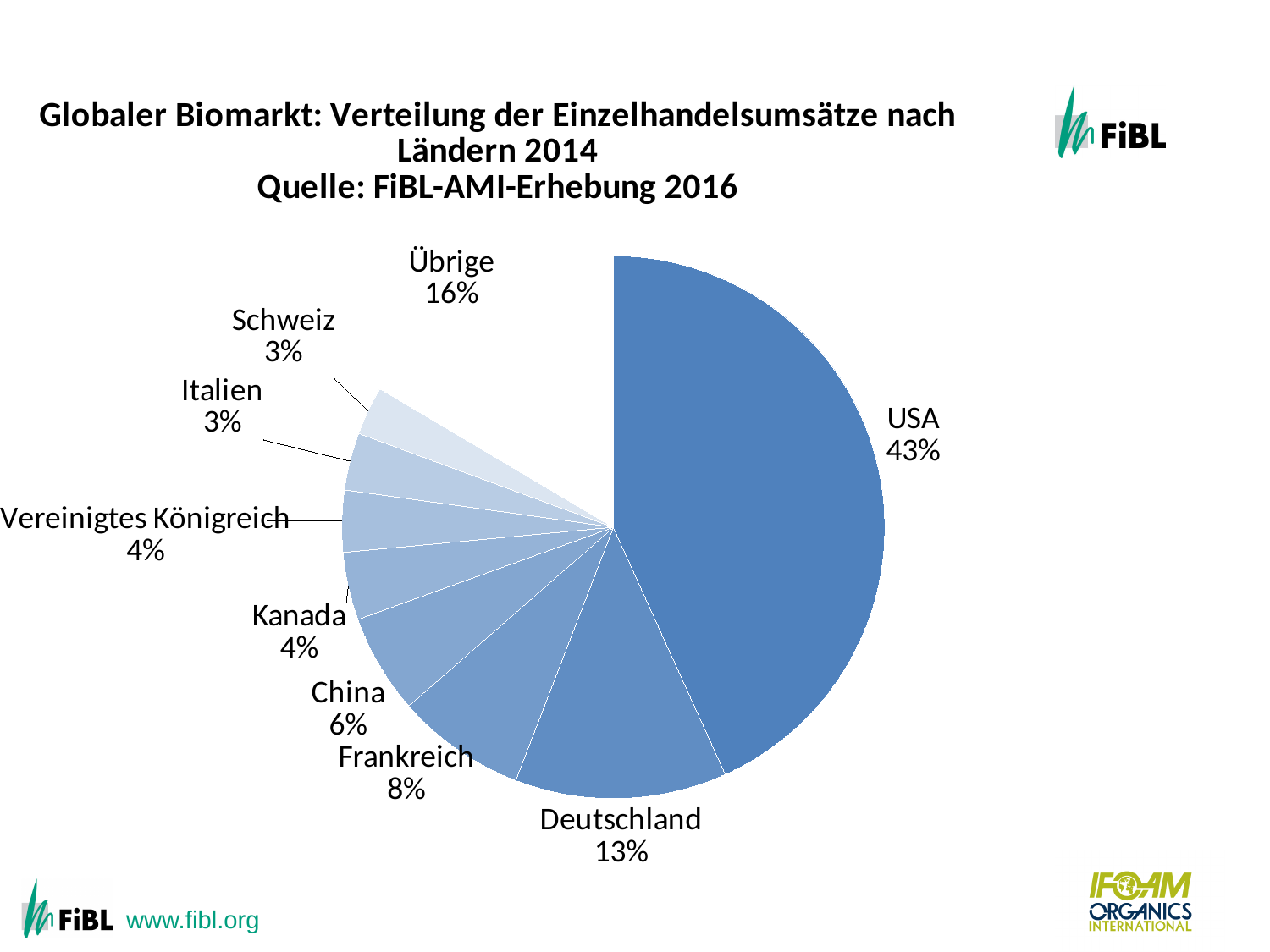
How many slices does the pie chart have? 9 What percentage is shown for Frankreich? 8% What source is cited in the chart title? FiBL-AMI-Erhebung 2016 What is the value for Übrige? 16% Which country has the largest slice of the pie? USA What is the difference between the shares of Übrige and China? 10% What share is shown for Vereinigtes Königreich? 4% What kind of chart is shown on the slide? Pie chart What share of the pie does USA hold? 43% What is the difference between the shares of USA and Deutschland? 30% Which is larger, the share for China or the share for Frankreich? Frankreich What is the value shown for Deutschland? 13%